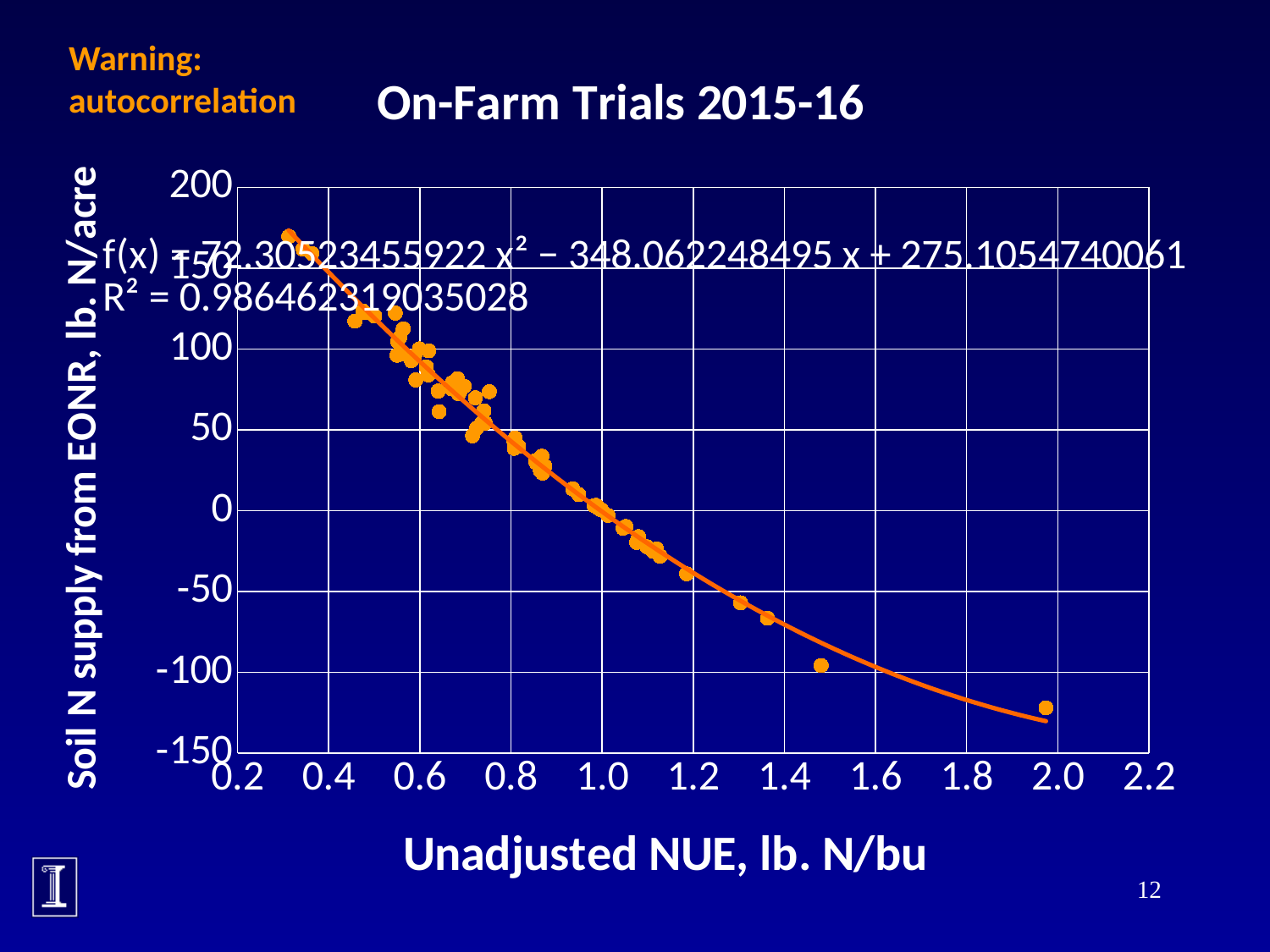
Is the Soil N supply value for the rightmost point (near 2.0 lb. N/bu) greater or less than -100? less Is the point with the highest Soil N supply value at the left end or the right end of the x axis? left end As Unadjusted NUE increases along the x axis, do the Soil N supply values rise or fall? fall Is the point with the lowest Soil N supply value at the left end or the right end of the x axis? right end Is the Soil N supply value for the leftmost point (near 0.3 lb. N/bu) greater or less than 150? greater What is the title of the chart? On-Farm Trials 2015-16 Is the Soil N supply value for the point near 1.5 lb. N/bu greater or less than -50? less What kind of chart is shown on the slide? scatter chart Which has the larger Soil N supply value: the point near 0.3 lb. N/bu or the point near 2.0 lb. N/bu? the point near 0.3 lb. N/bu What R² value is printed on the chart for the fitted trendline? 0.986462319035028